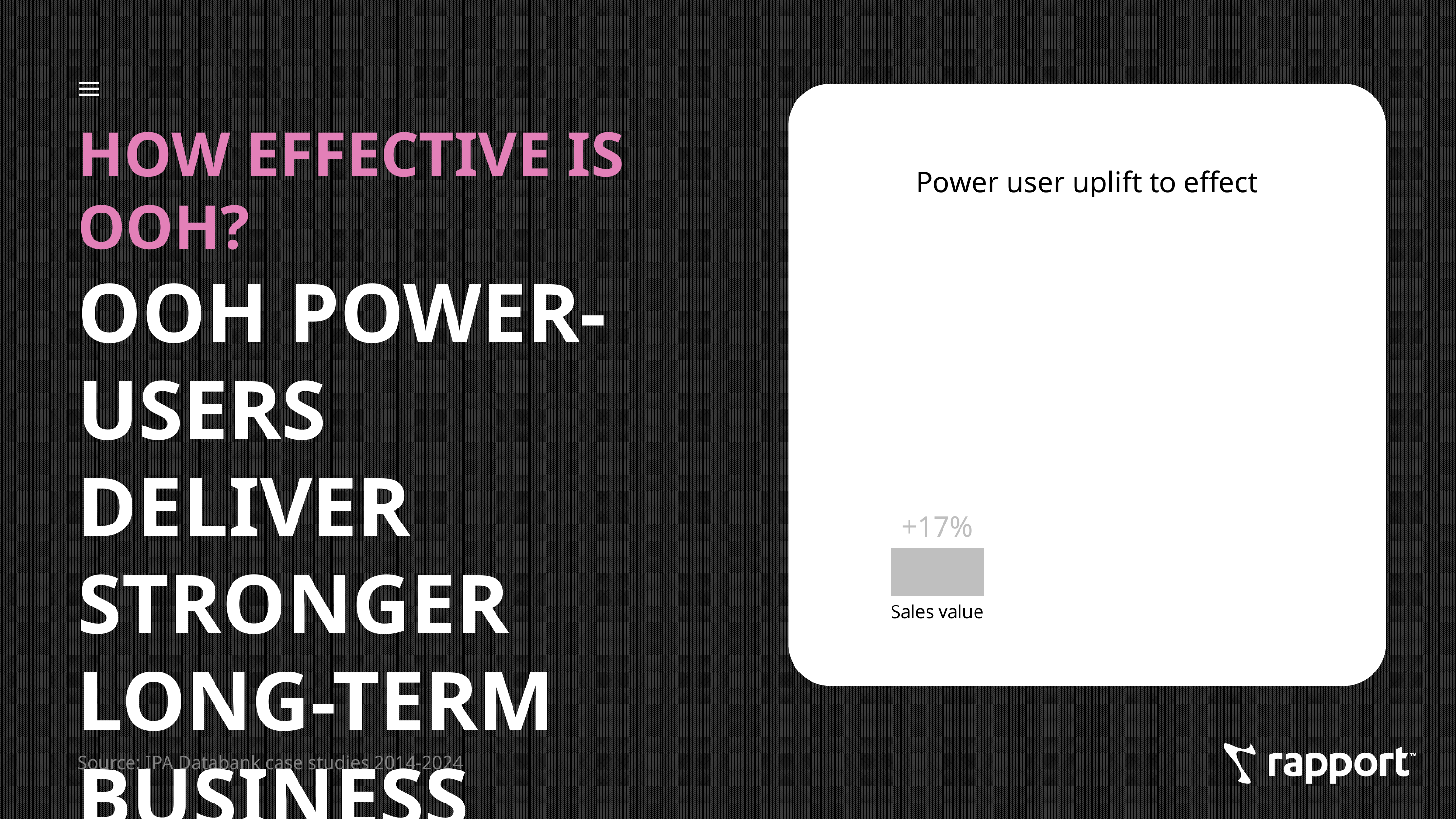
What is the label of the only category on the chart's x axis? Sales value Is the value for Sales value greater or less than 10%? greater What kind of chart is shown on the slide? bar chart What is the title of the chart? Power user uplift to effect How many categories are plotted in the chart? 1 What is the value shown for Sales value in the chart? +17%